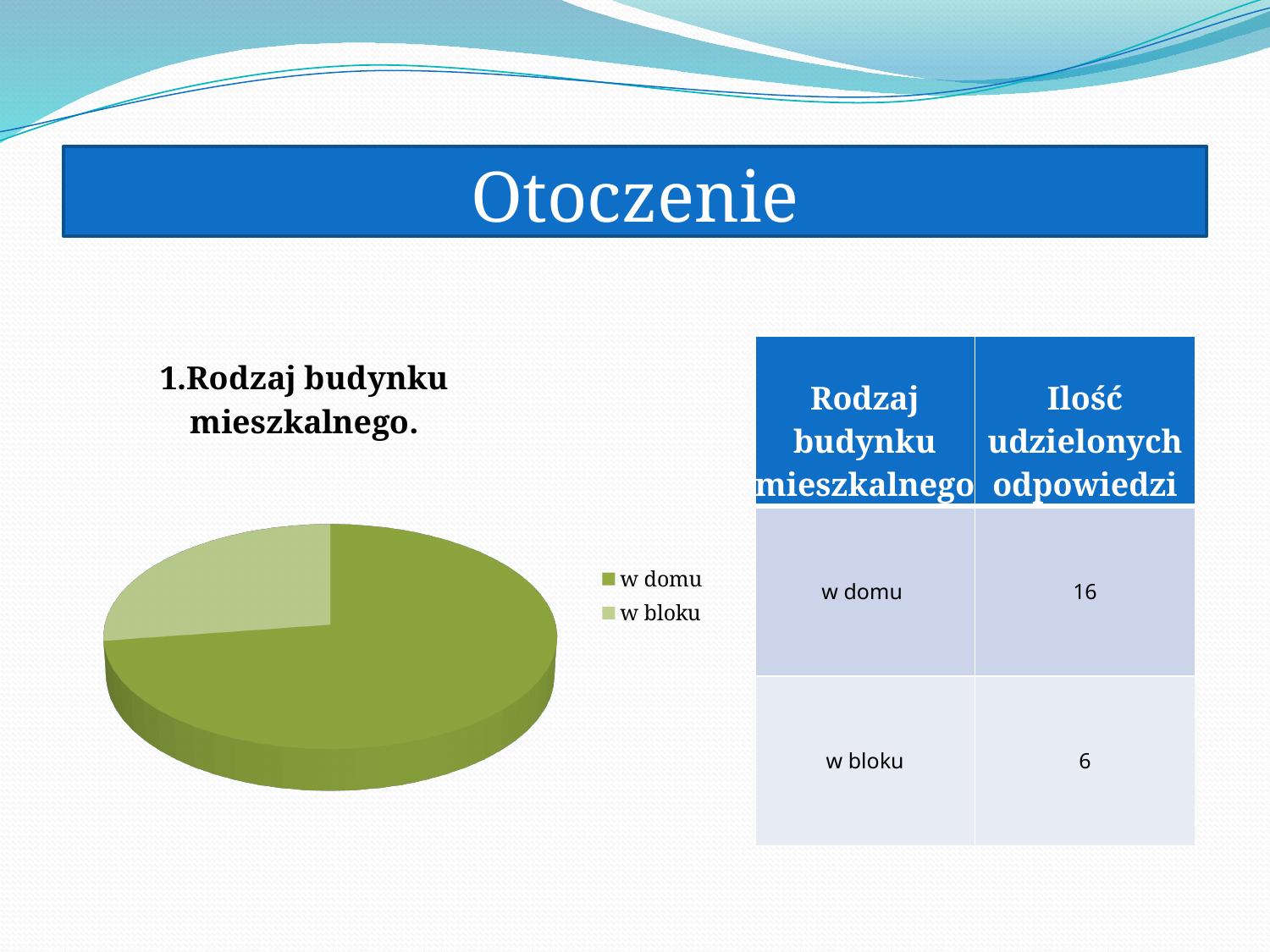
Which category has the smallest slice of the pie chart? w bloku How many slices does the pie chart have? 2 What are the two legend entries of the pie chart? w domu, w bloku Using the values in the table, what is the difference between the number of responses for w domu and w bloku? 10 How many entries does the chart legend list? 2 What is the title of the chart? 1.Rodzaj budynku mieszkalnego. Which slice is larger, w domu or w bloku? w domu What kind of chart is shown on the slide? pie chart Which category has the largest slice of the pie chart? w domu According to the table next to the chart, how many responses does w domu have? 16 According to the table next to the chart, how many responses does w bloku have? 6